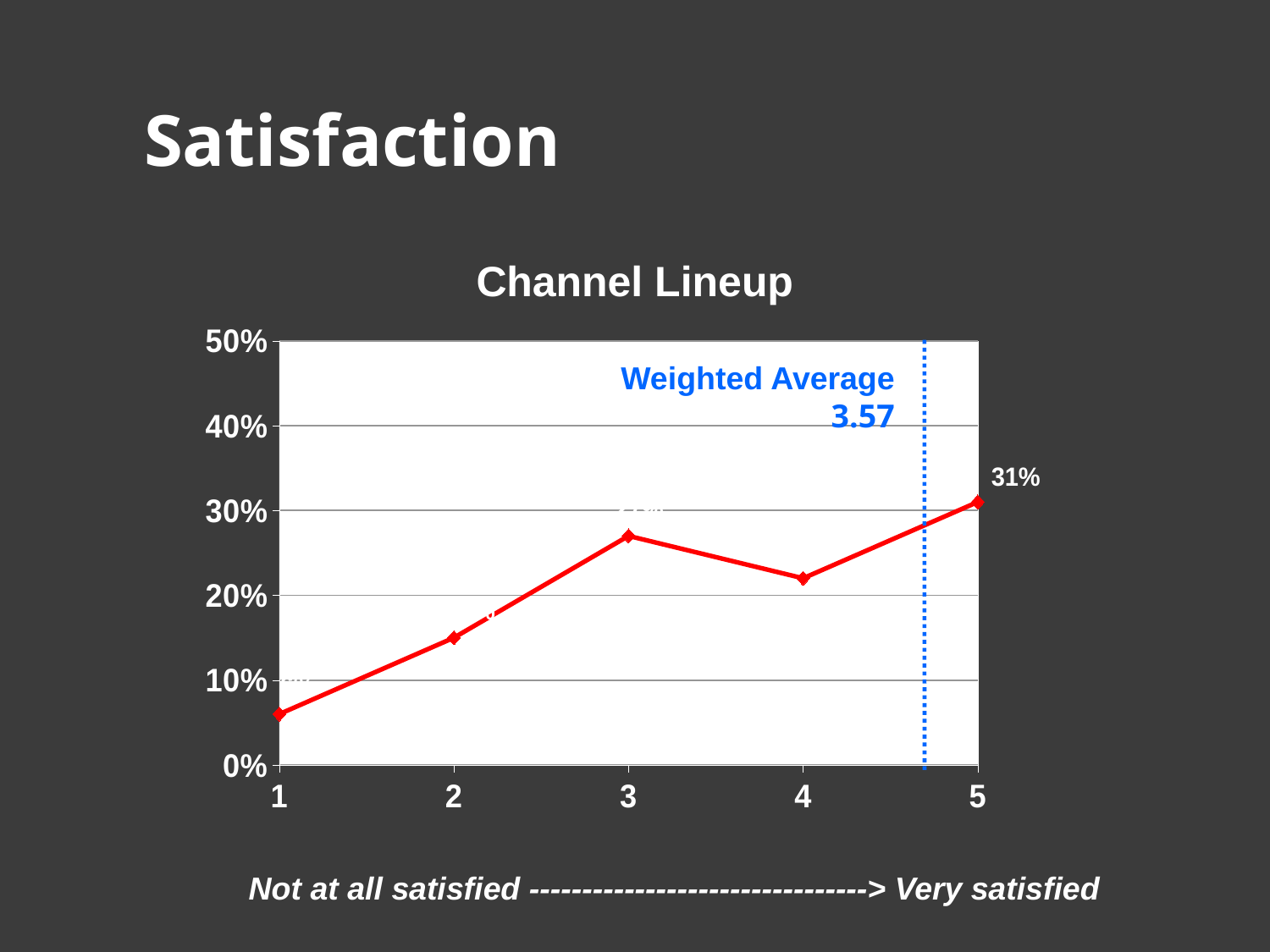
Which has the larger value, category 3 or category 4? 3 How many data points are plotted on the Channel Lineup chart? 5 What is the value plotted for category 5 in the Channel Lineup chart? 31% Which category has the lowest value in the Channel Lineup chart? 1 Is the value for category 2 greater or less than 20%? less Which category has the highest value in the Channel Lineup chart? 5 Is the value for category 4 greater or less than 30%? less Is the value for category 1 greater or less than 10%? less Do the values generally rise or fall from category 1 to category 5? rise What kind of chart is shown on the slide? line chart What weighted average is shown on the Channel Lineup chart? 3.57